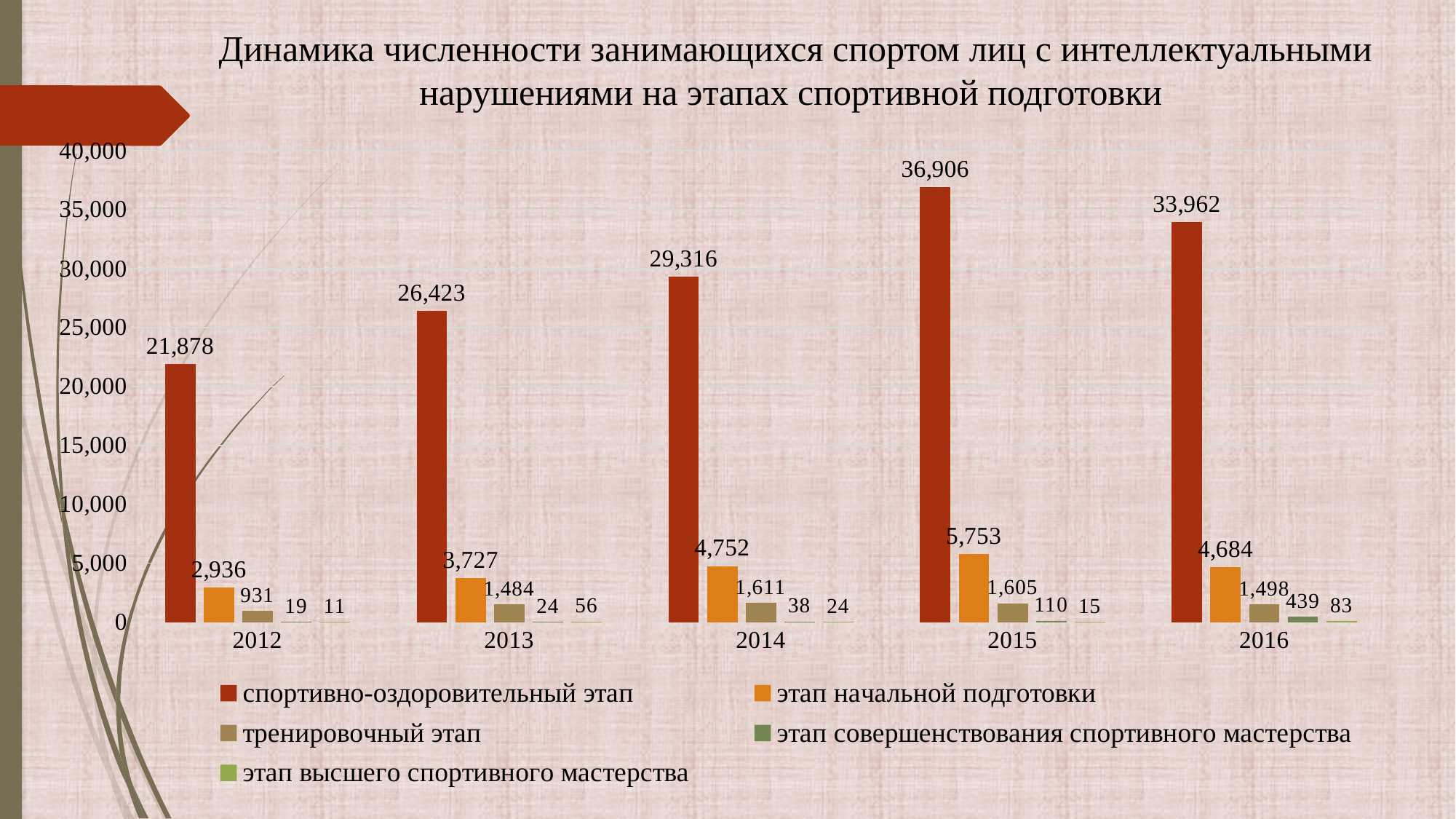
What is the value for "этап совершенствования спортивного мастерства" in 2016? 439 What is the difference between the "спортивно-оздоровительный этап" values for 2015 and 2016? 2,944 What is the value for "спортивно-оздоровительный этап" in 2015? 36,906 How many years are shown on the x axis? 5 What is the value for "тренировочный этап" in 2016? 1,498 How many series does the legend list? 5 In which year is the value for "этап начальной подготовки" lowest? 2012 What is the value for "этап начальной подготовки" in 2013? 3,727 In which year is the value for "спортивно-оздоровительный этап" highest? 2015 Which is larger: the "тренировочный этап" value in 2014 or in 2015? 2014 What kind of chart is shown on the slide? Bar chart What is the difference between the "этап начальной подготовки" values for 2015 and 2014? 1,001